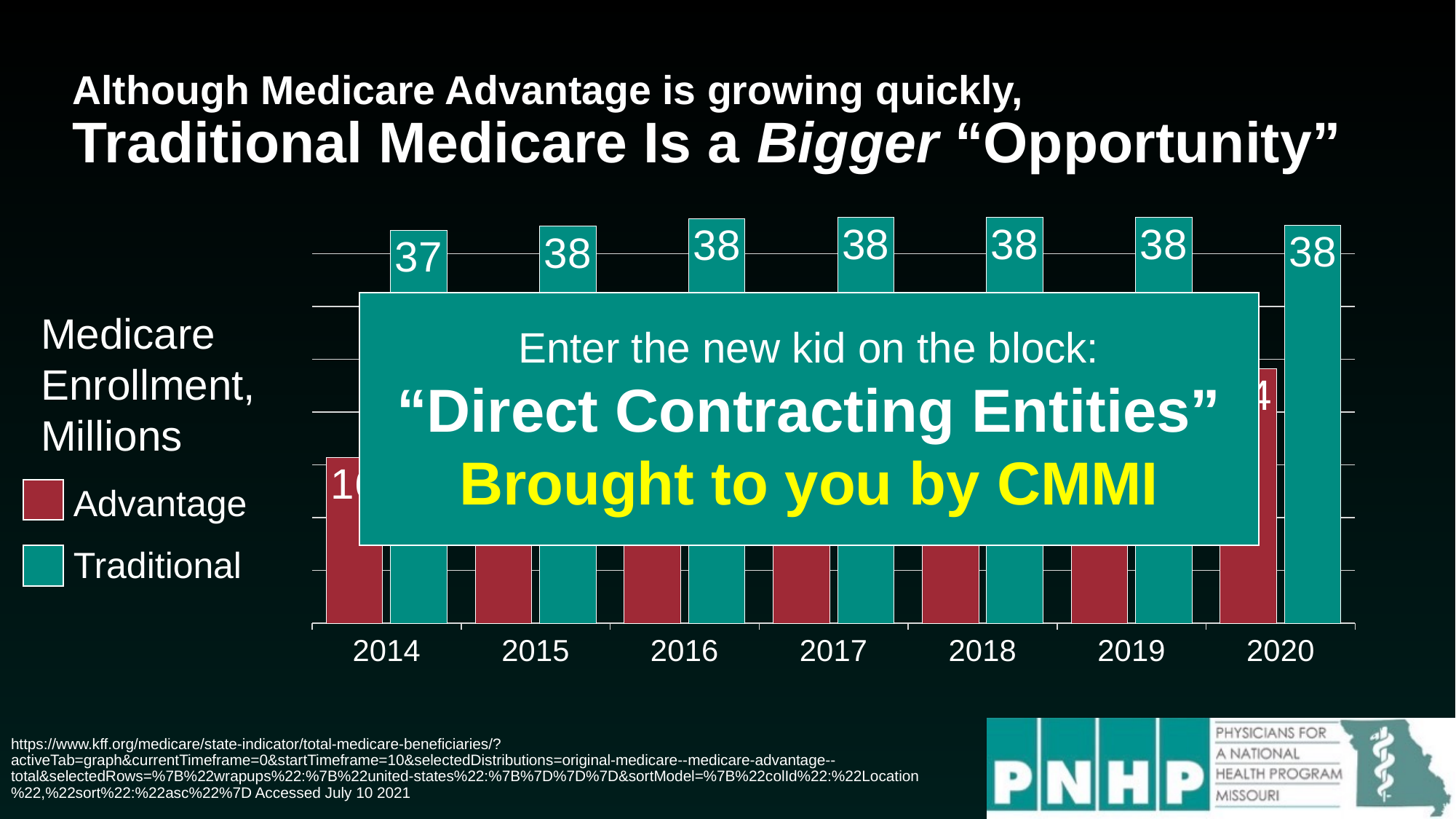
What is the Traditional Medicare enrollment value shown for 2017? 38 What is the difference between the Traditional values for 2020 and 2014? 1 How many years are shown on the x axis of the chart? 7 What is the Traditional Medicare enrollment value shown for 2020? 38 What is the Traditional Medicare enrollment value shown for 2014? 37 In which year is the Traditional series at its lowest value? 2014 In 2014, which series has the larger value, Advantage or Traditional? Traditional What kind of chart is shown on the slide? Bar chart In 2020, which series has the larger value, Advantage or Traditional? Traditional Does the Traditional series rise or fall from 2014 to 2015? Rise What are the two series named in the chart's legend? Advantage and Traditional How many series does the chart's legend list? 2